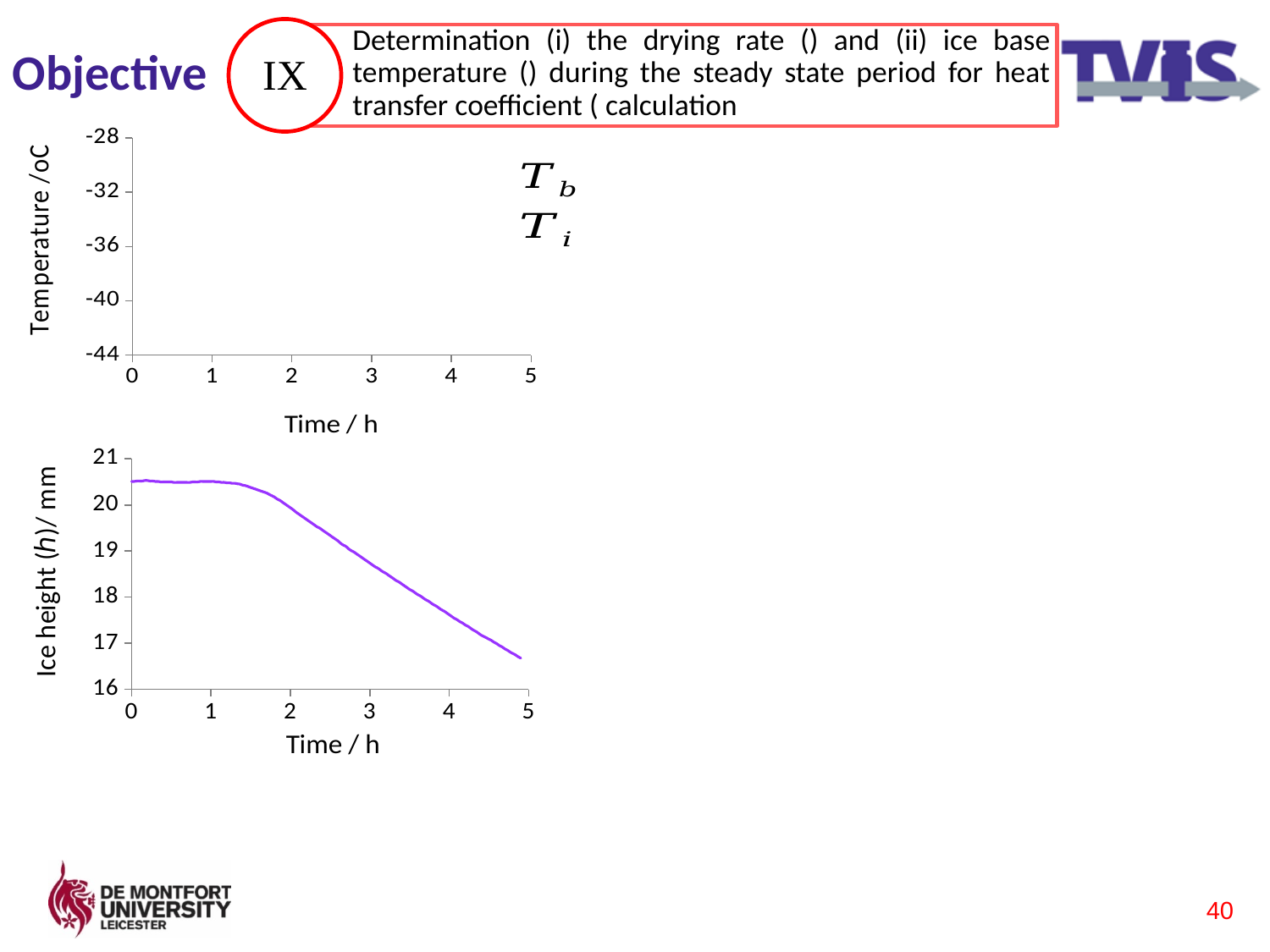
What kind of chart is the bottom chart (Ice height vs Time)? line chart In the bottom chart (Ice height vs Time), is the ice height at time 0 h greater or less than 20 mm? greater In the bottom chart (Ice height vs Time), at which plotted time is the ice height lowest, the start (0 h) or the end (about 5 h)? the end (about 5 h) What is the label of the y axis on the top chart? Temperature /oC What is the label of the y axis on the bottom chart? Ice height (h)/ mm In the bottom chart (Ice height vs Time), is the ice height larger at time 1 h or at time 4 h? time 1 h In the bottom chart (Ice height vs Time), is the ice height at time 1 h greater or less than 20 mm? greater In the bottom chart (Ice height vs Time), is the ice height at time 4 h greater or less than 18 mm? less In the bottom chart (Ice height vs Time), does the ice height rise or fall as time increases? fall